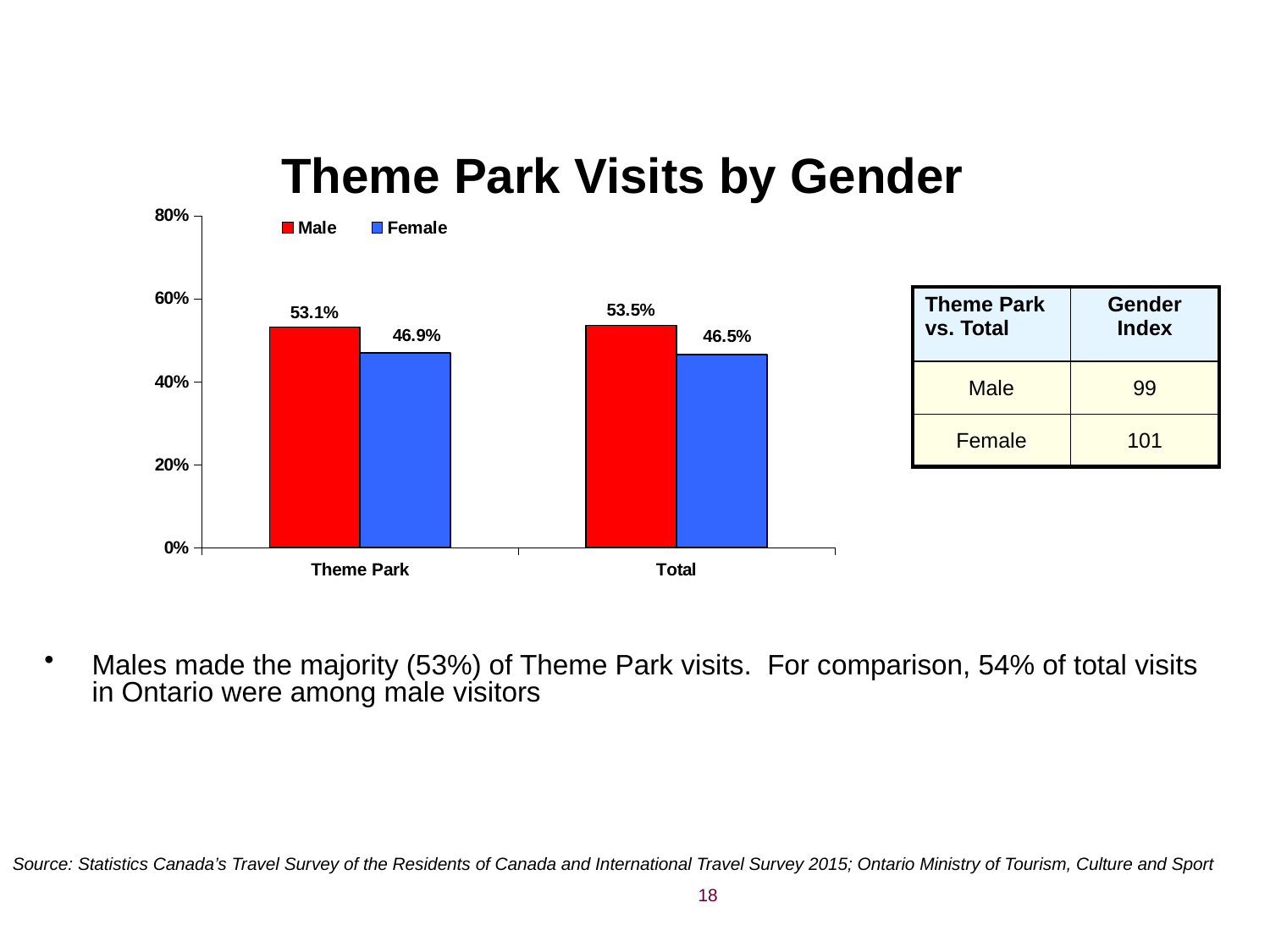
What is the difference between the Male and Female values for Total? 7.0% How many series does the legend list? 2 What is the Male value for Theme Park? 53.1% What is the Male value for Total? 53.5% What is the Female value for Theme Park? 46.9% What is the difference between the Male and Female values for Theme Park? 6.2% How many categories are shown on the x axis? 2 What kind of chart is shown? bar chart What is the title of the chart? Theme Park Visits by Gender What is the Female value for Total? 46.5% Is the Female value for Total greater or less than 40%? greater Which is larger for Theme Park, the Male value or the Female value? Male